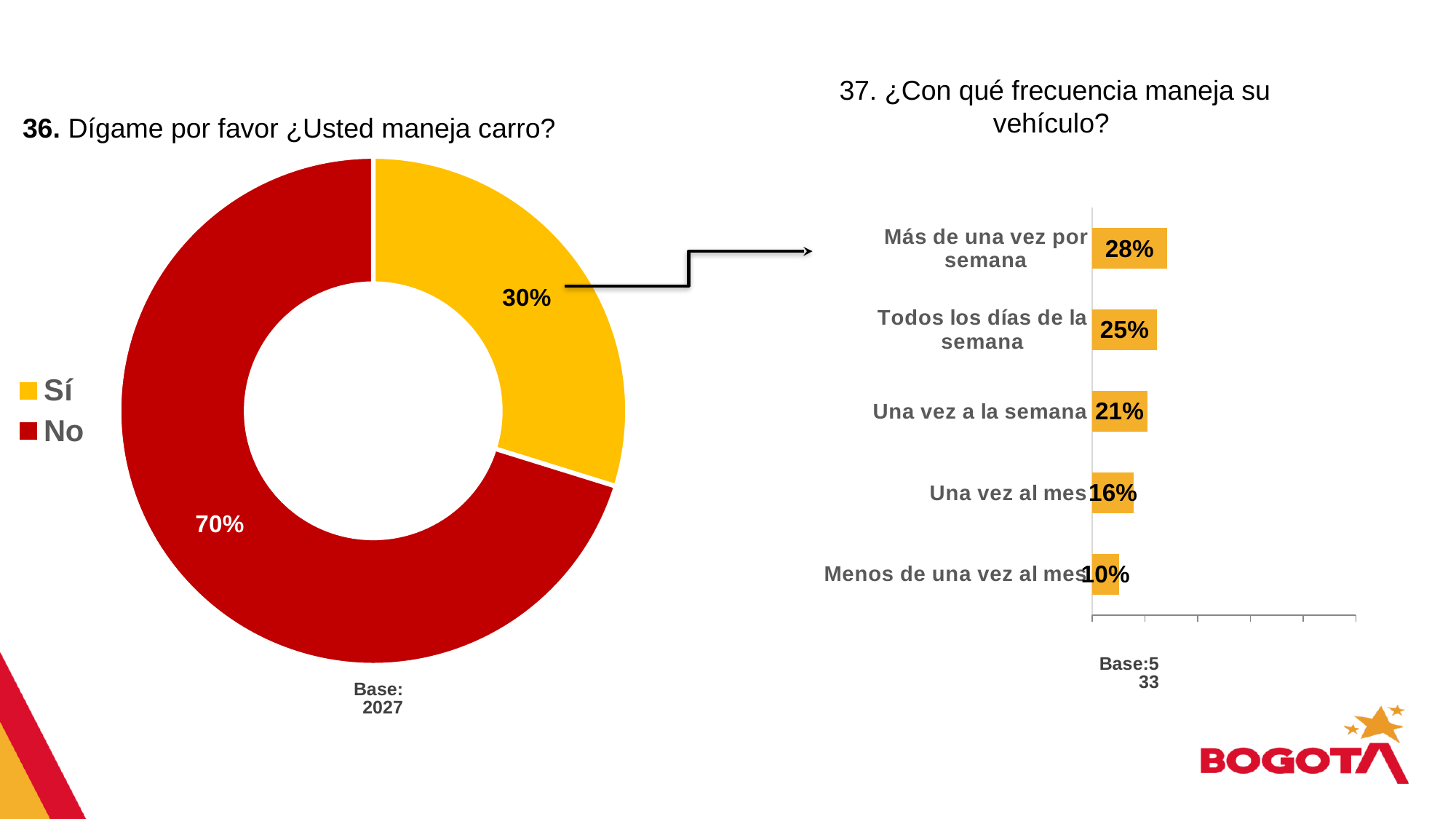
In the donut chart for question 36, which answer has the larger share, 'Sí' or 'No'? No In the donut chart for question 36, how many entries does the legend list? 2 In the donut chart for question 36 (¿Usted maneja carro?), what percentage answered 'No'? 70% In the bar chart for question 37, what is the difference in percentage points between 'Más de una vez por semana' and 'Una vez a la semana'? 7 In the donut chart for question 36, what percentage answered 'Sí'? 30% In the bar chart for question 37, how many categories are shown? 5 What type of chart is used for question 37? Bar chart In the bar chart for question 37, what is the value for 'Una vez al mes'? 16% In the bar chart for question 37, which category has the lowest value? Menos de una vez al mes In the donut chart for question 36, what is the difference in percentage points between 'No' and 'Sí'? 40 In the bar chart for question 37 (¿Con qué frecuencia maneja su vehículo?), what is the value for 'Todos los días de la semana'? 25% In the bar chart for question 37, which category has the highest value? Más de una vez por semana